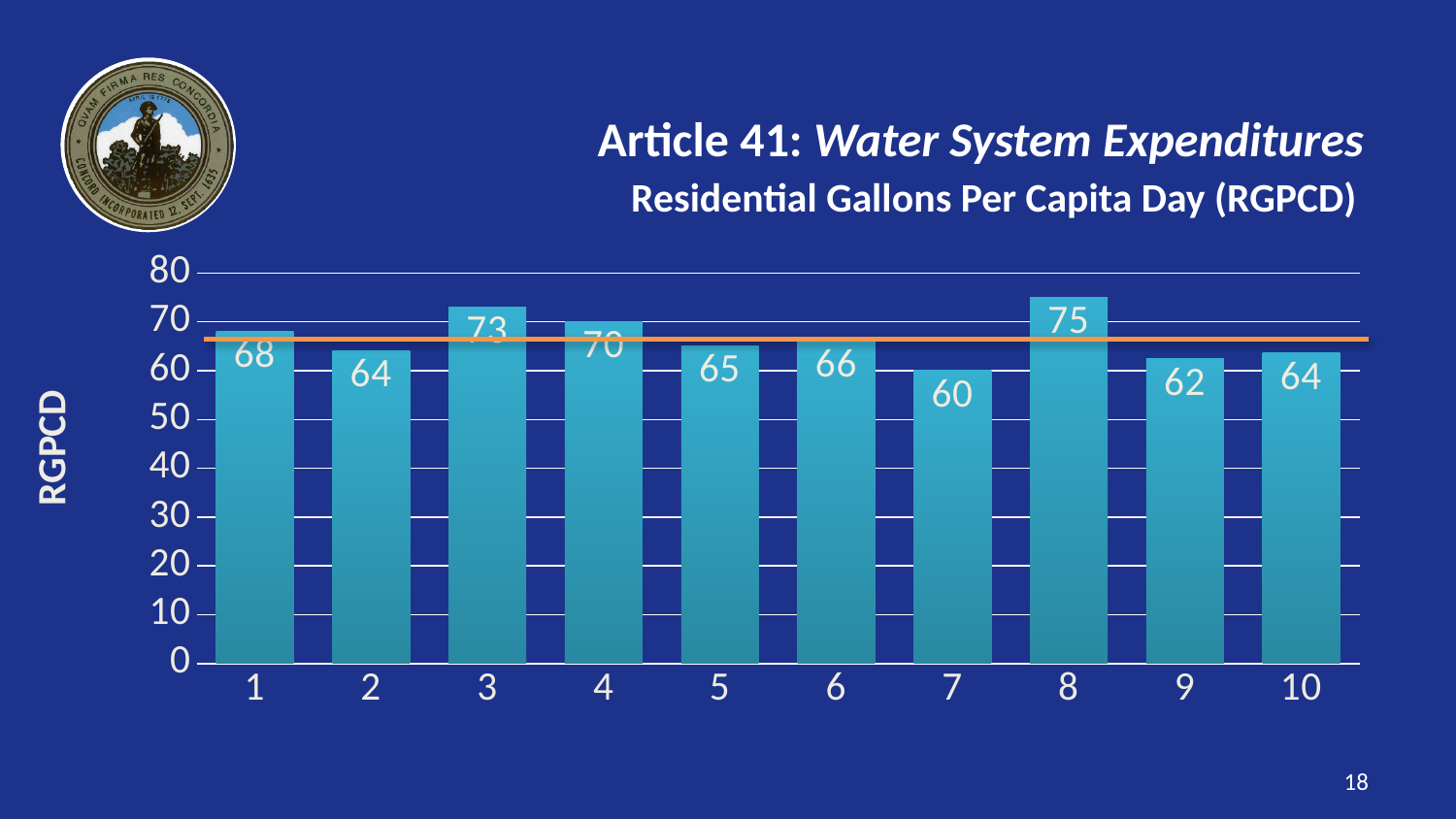
What is the RGPCD value for category 8? 75 What is the label on the vertical axis of the chart? RGPCD What is the difference between the RGPCD values for category 8 and category 7? 15 What is the RGPCD value for category 3? 73 What is the RGPCD value for category 7? 60 Is the RGPCD value for category 8 greater or less than 70? greater Which has a larger RGPCD value, category 4 or category 9? category 4 What kind of chart is shown on the slide? bar chart Which category has the highest RGPCD value? 8 What is the difference between the RGPCD values for category 3 and category 1? 5 Which category has the lowest RGPCD value? 7 How many categories are shown on the x axis? 10